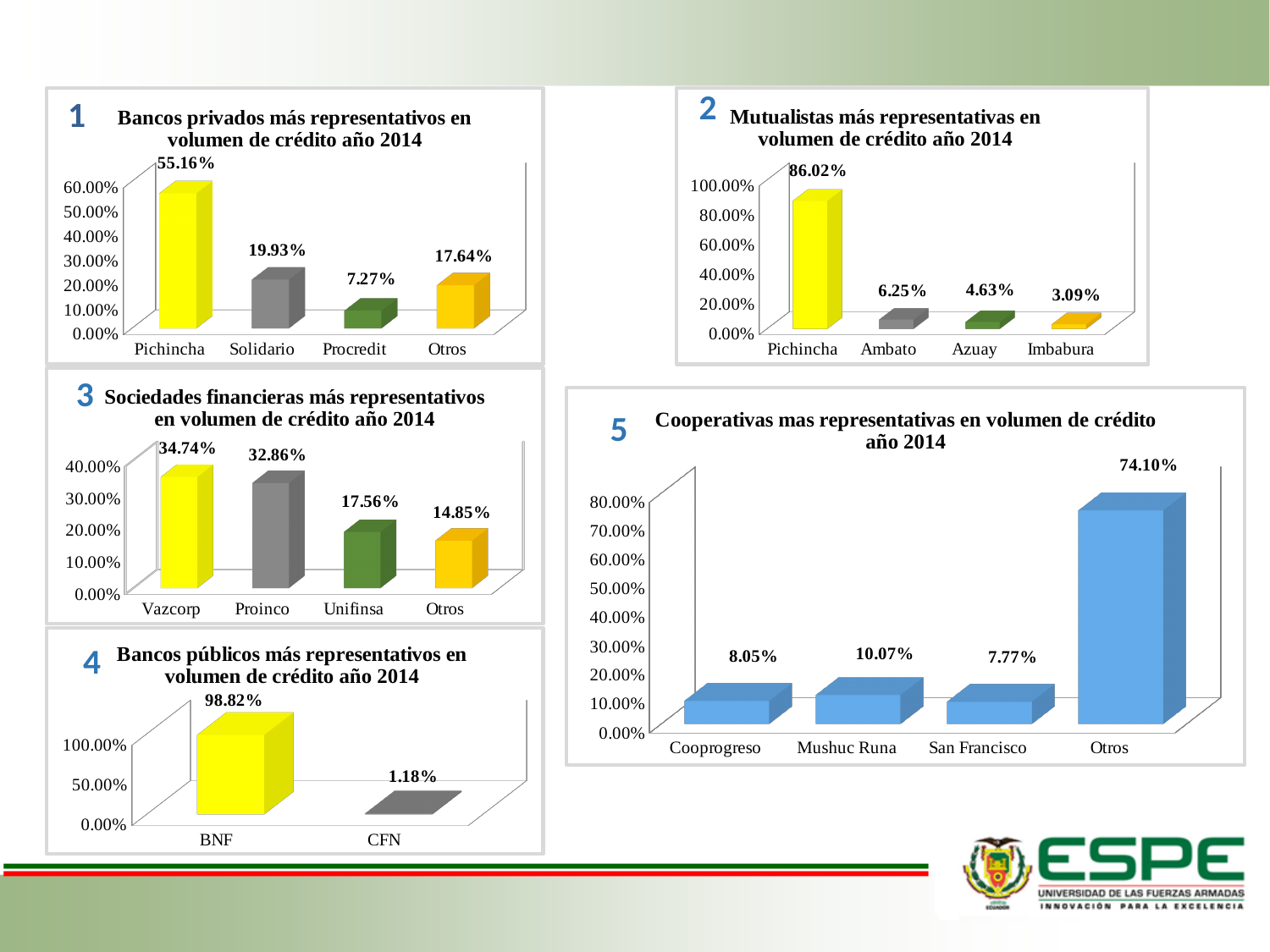
In the chart 'Mutualistas más representativas en volumen de crédito año 2014', what is the value for Imbabura? 3.09% In the chart 'Bancos públicos más representativos en volumen de crédito año 2014', how many categories are shown? 2 In the chart 'Sociedades financieras más representativos en volumen de crédito año 2014', what is the difference between Vazcorp and Proinco? 1.88% In the chart 'Bancos privados más representativos en volumen de crédito año 2014', what is the value for Solidario? 19.93% In the chart 'Mutualistas más representativas en volumen de crédito año 2014', which category has the highest value? Pichincha In the chart 'Cooperativas mas representativas en volumen de crédito año 2014', which is larger, Cooprogreso or Mushuc Runa? Mushuc Runa In the chart 'Bancos privados más representativos en volumen de crédito año 2014', what is the difference between Solidario and Otros? 2.29% In the chart 'Cooperativas mas representativas en volumen de crédito año 2014', what is the value for Otros? 74.10% What kind of chart is 'Cooperativas mas representativas en volumen de crédito año 2014'? Bar chart In the chart 'Bancos privados más representativos en volumen de crédito año 2014', which bank has the lowest value? Procredit In the chart 'Bancos públicos más representativos en volumen de crédito año 2014', what is the value for CFN? 1.18% In the chart 'Sociedades financieras más representativos en volumen de crédito año 2014', what is the value for Unifinsa? 17.56%